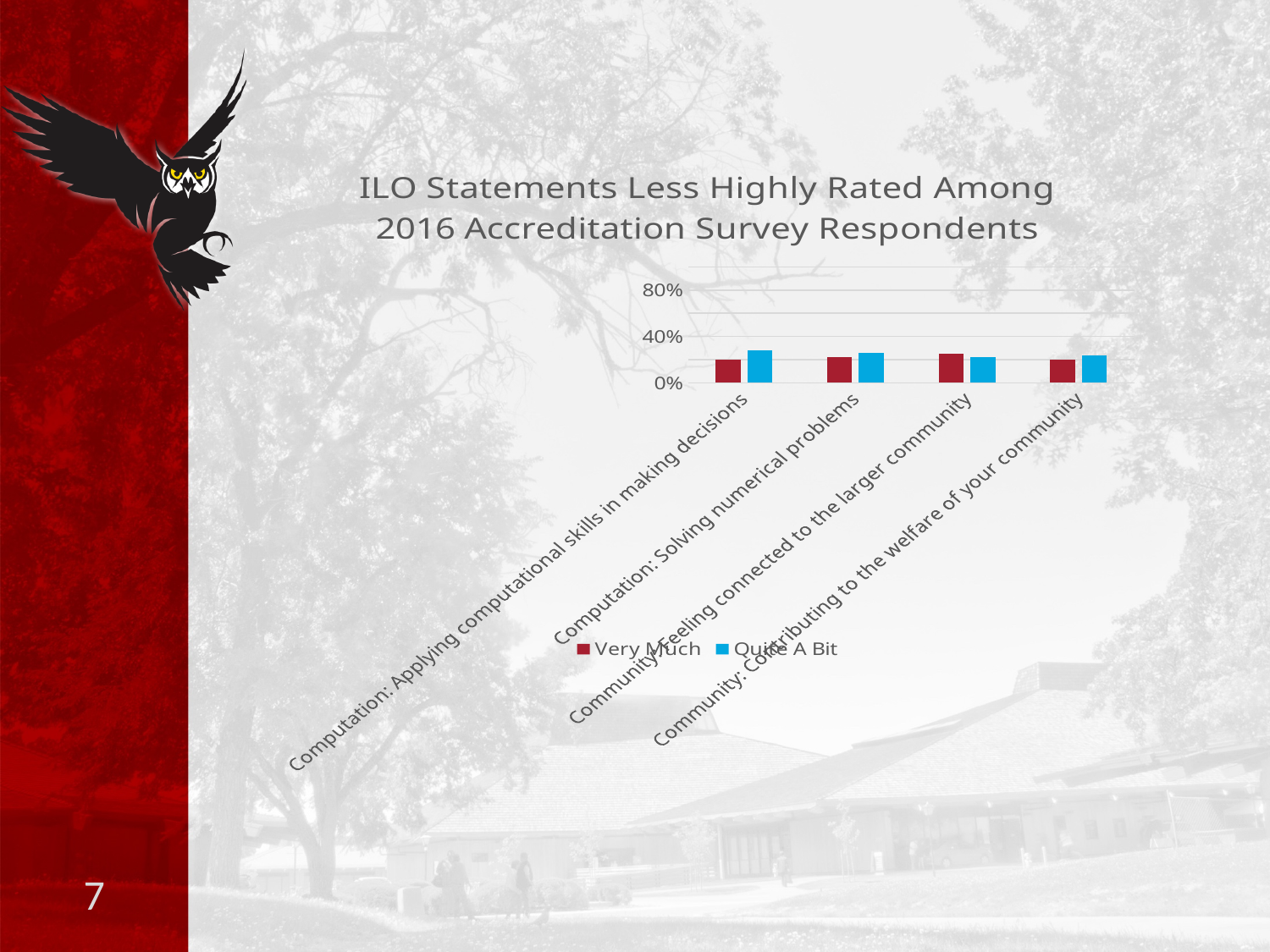
Is the Very Much value for "Computation: Applying computational skills in making decisions" greater or less than 40%? less Is the Quite A Bit value for "Computation: Solving numerical problems" greater or less than 40%? less Which category has the highest Very Much value? Community: Feeling connected to the larger community What is the title of the chart? ILO Statements Less Highly Rated Among 2016 Accreditation Survey Respondents How many series does the legend list? 2 Is the Quite A Bit value for "Community: Contributing to the welfare of your community" greater or less than 40%? less What are the two series named in the legend? Very Much and Quite A Bit How many categories are shown on the x axis? 4 For "Computation: Applying computational skills in making decisions", which series has the larger value, Very Much or Quite A Bit? Quite A Bit What kind of chart is shown on the slide? bar chart